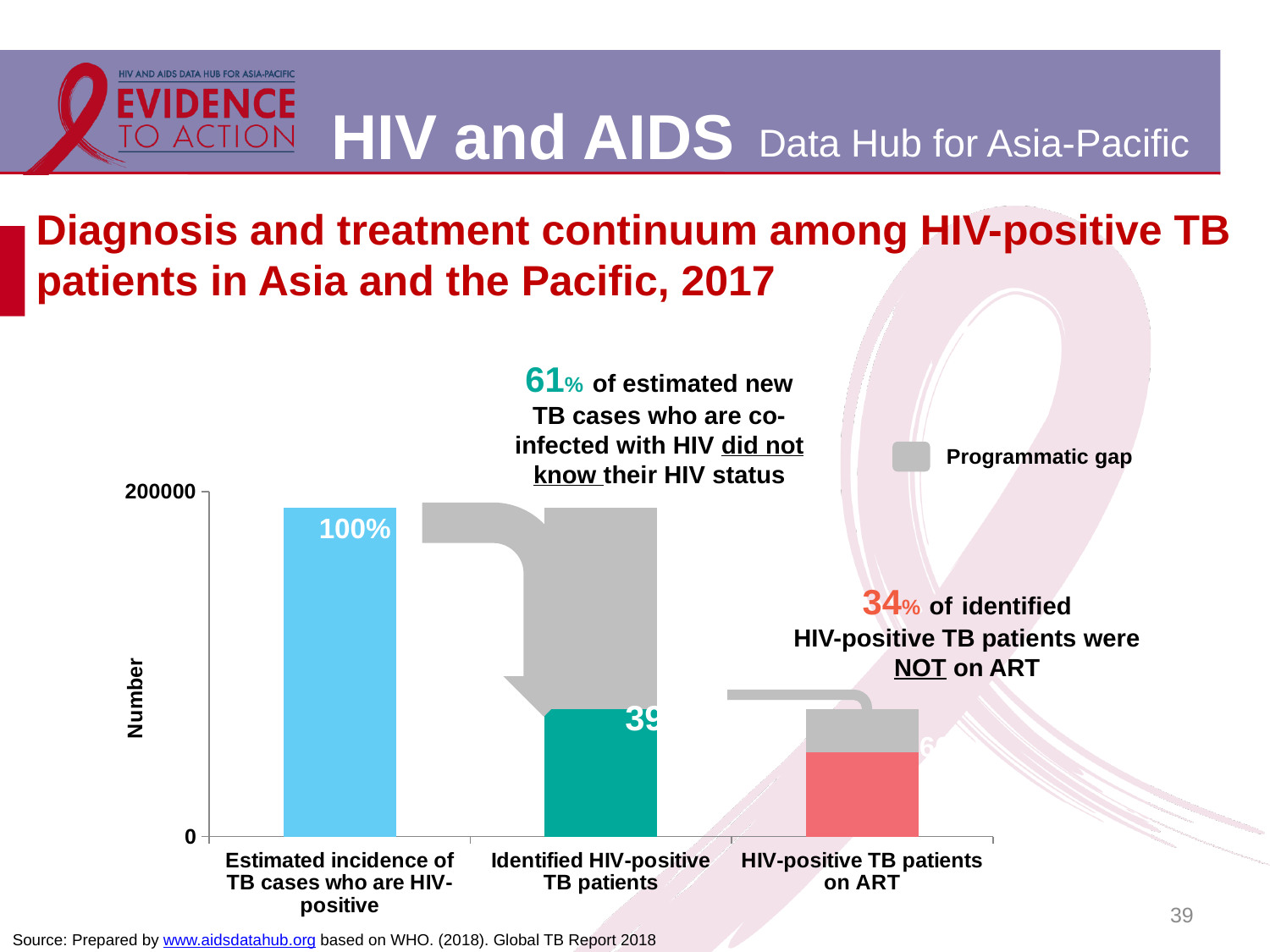
Which category has the lowest bar? HIV-positive TB patients on ART According to the annotation on the chart, what percentage of estimated new TB cases co-infected with HIV did not know their HIV status? 61% What is the label of the y axis of the chart? Number Do the bar values rise or fall from left to right along the x axis? fall What percentage label is shown on the bar for 'Estimated incidence of TB cases who are HIV-positive'? 100% According to the annotation on the chart, what percentage of identified HIV-positive TB patients were not on ART? 34% What kind of chart is shown on the slide? bar chart Is the value for 'Identified HIV-positive TB patients' greater or less than 200000? less Which bar is taller: 'Identified HIV-positive TB patients' or 'HIV-positive TB patients on ART'? Identified HIV-positive TB patients How many categories are shown on the x axis of the chart? 3 Which category has the highest bar? Estimated incidence of TB cases who are HIV-positive What does the grey legend entry on the chart represent? Programmatic gap